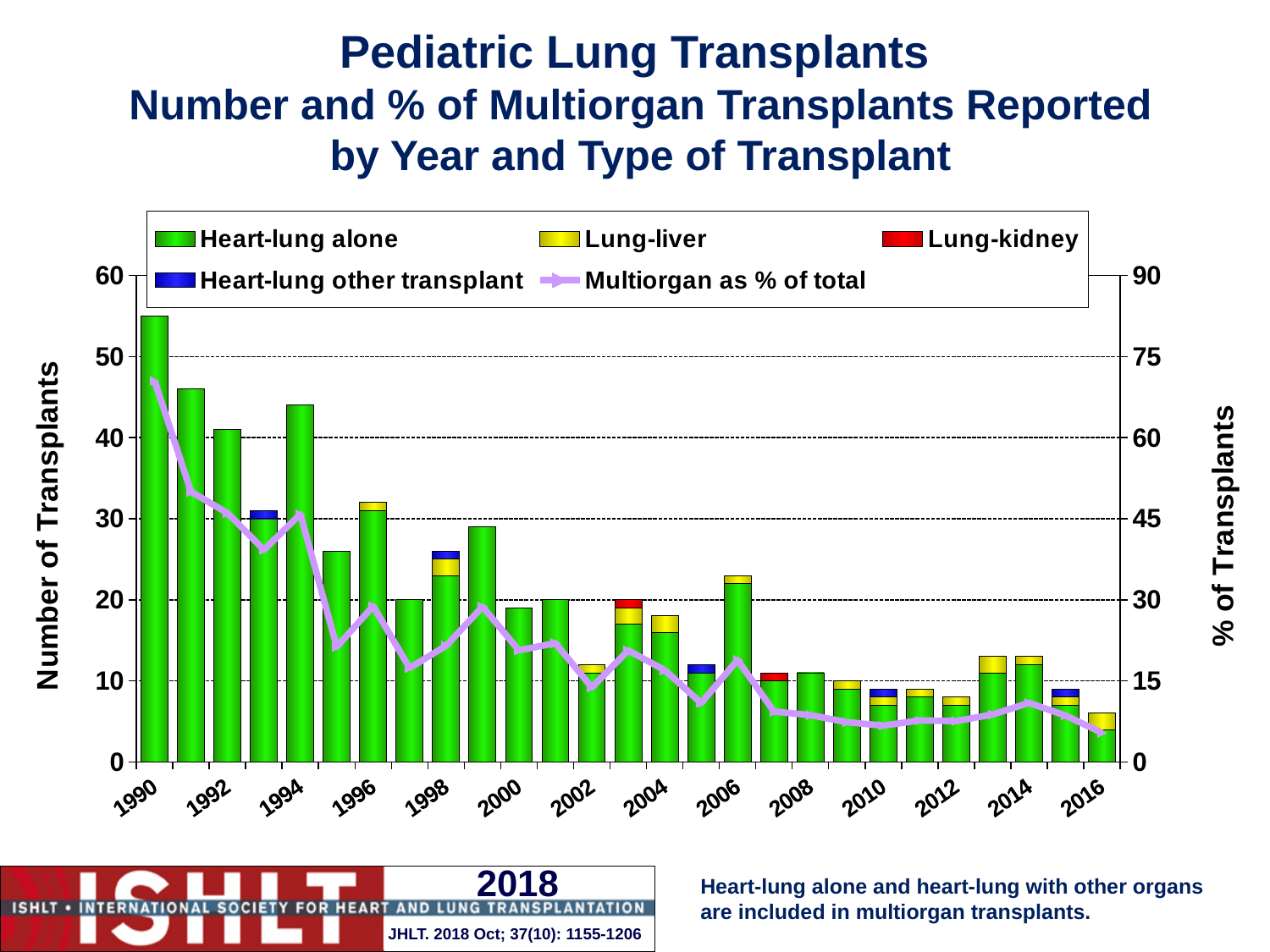
Which year has the highest total number of transplants? 1990 Which year has more total transplants, 1990 or 1992? 1990 Which year has the lowest total number of transplants? 2016 Which legend entry is shown in red? Lung-kidney Is the total number of transplants in 2016 greater or less than 10? less Does the number of transplants generally rise or fall from 1990 to 2016? Fall Is the Multiorgan as % of total value for 1990 greater or less than 60? greater Is the total number of transplants in 1994 greater or less than 40? greater What kind of chart is shown on the slide? Stacked bar chart with a line How many years (bars) are plotted on the x axis? 27 How many series does the legend list? 5